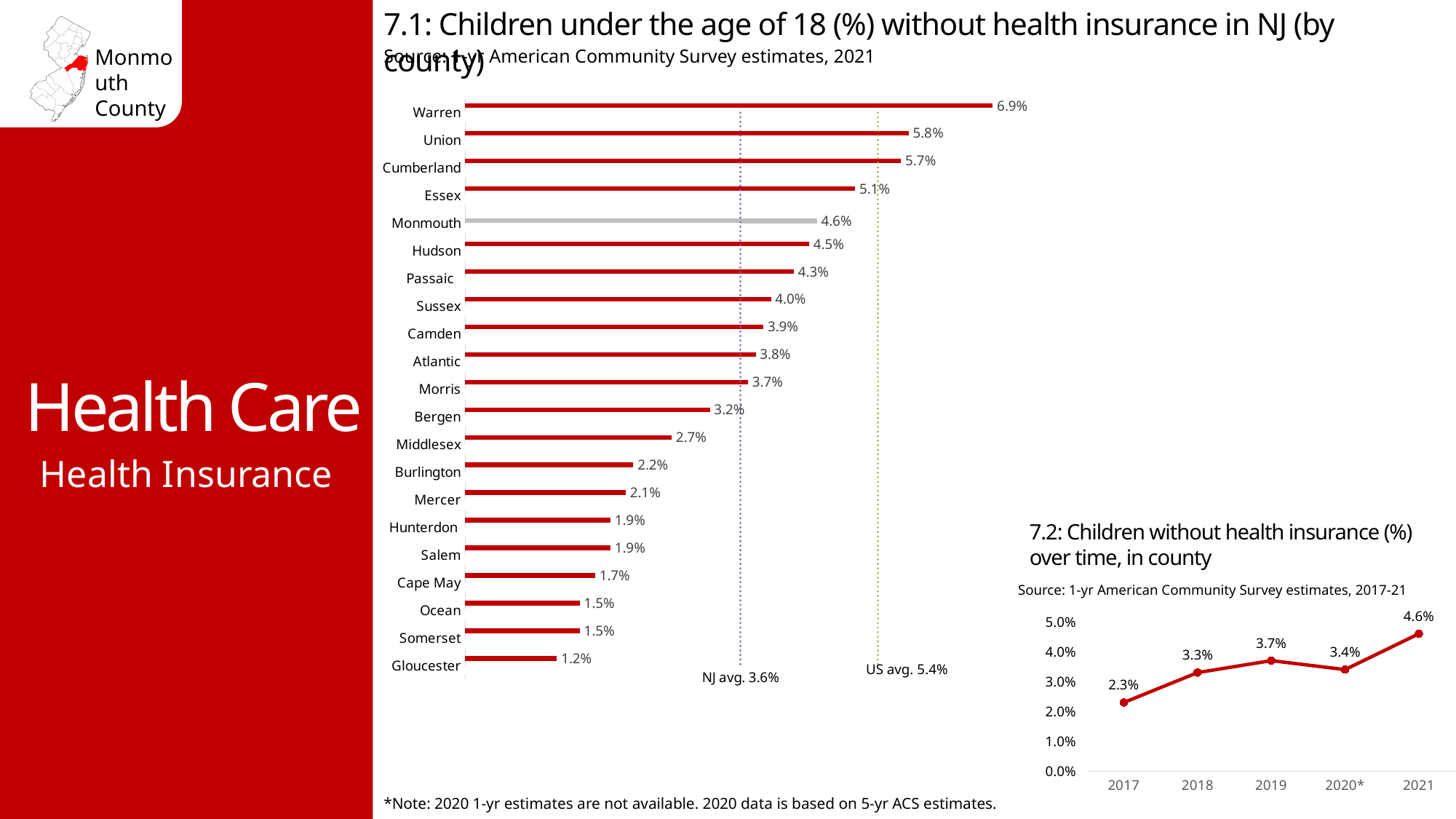
In chart 7.2, how many data points are plotted? 5 In chart 7.2, what was the percentage of children without health insurance in 2017? 2.3% In chart 7.1, what percentage of children under 18 in Monmouth County are without health insurance? 4.6% In chart 7.1, which county has the highest percentage of children without health insurance? Warren In chart 7.2, what is the difference between the 2021 value and the 2020* value? 1.2% In chart 7.1, which county has the lowest percentage of children without health insurance? Gloucester In chart 7.1, how many counties are shown? 21 In chart 7.1, what is the value for Cumberland? 5.7% In chart 7.1, what is the difference between Warren and Gloucester? 5.7% In chart 7.1, what is the NJ average shown by the dotted line? 3.6% What type of chart is chart 7.2? Line chart In chart 7.1, which is larger, the value for Hudson or the value for Passaic? Hudson